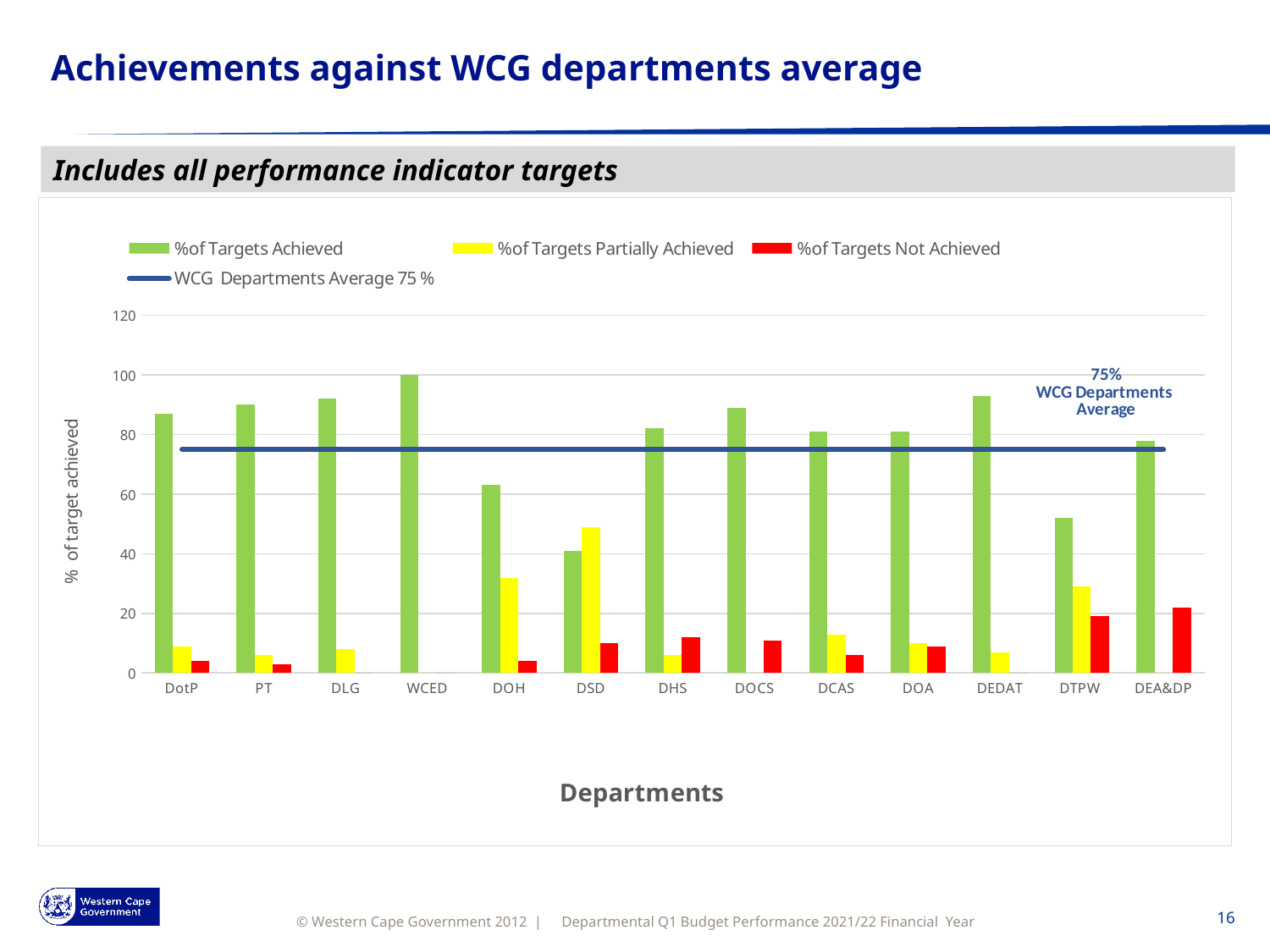
How many entries does the legend list? 4 What is the % of Targets Achieved for WCED? 100 What is the title of the y axis? % of target achieved Which department has the highest % of Targets Achieved? WCED How many departments are shown along the x axis? 13 What kind of chart is shown on the slide? combination bar and line chart What value does the WCG Departments Average line represent? 75% Which has a higher % of Targets Achieved, DEDAT or DTPW? DEDAT Is the % of Targets Achieved for DOH greater or less than 80? less Is the % of Targets Achieved for DTPW greater or less than 60? less Is the % of Targets Not Achieved for DEA&DP greater or less than 10? greater Which department has the lowest % of Targets Achieved? DSD